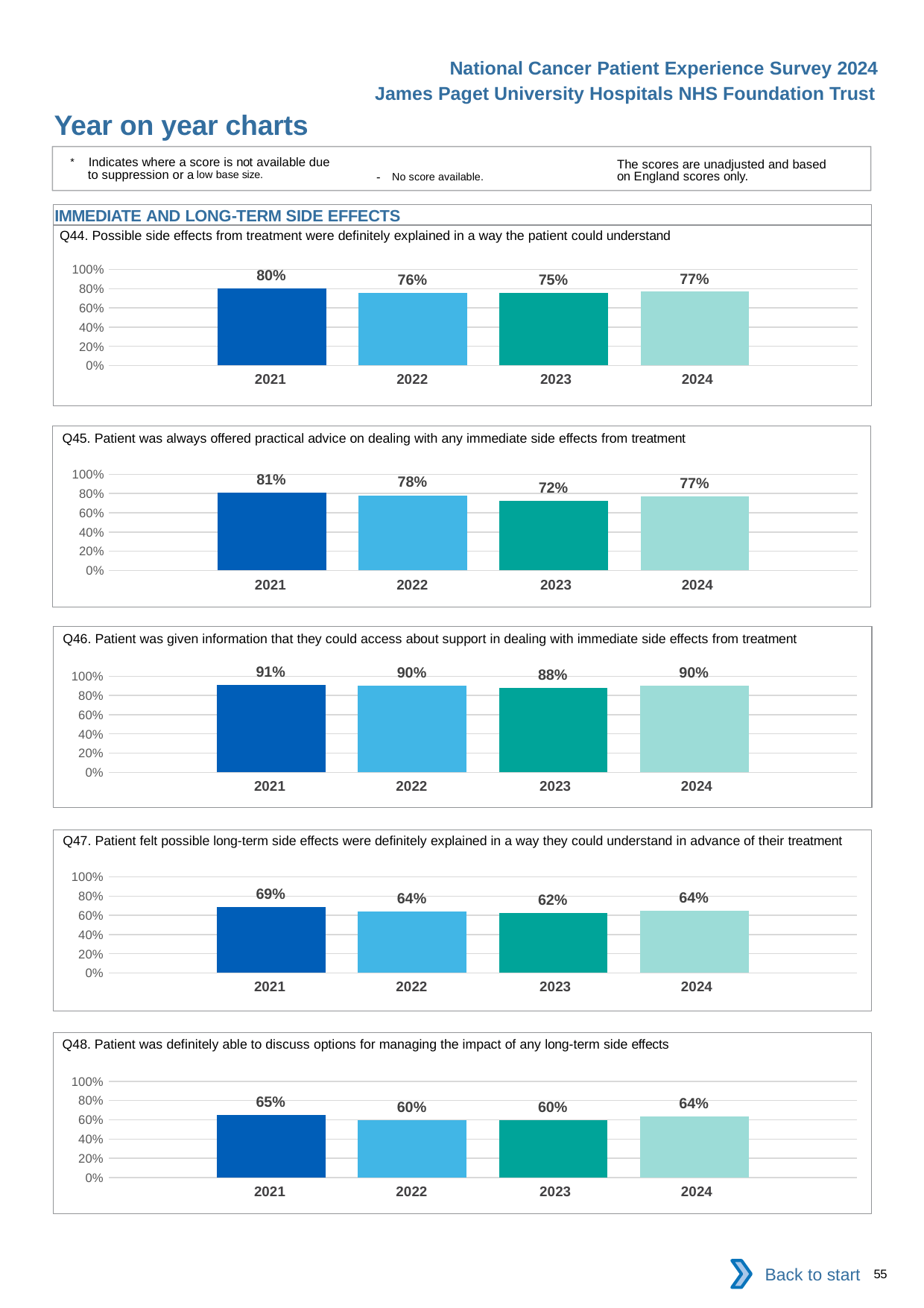
In the Q44 chart, what is the value for 2021? 80% In the Q45 chart, which year has the lowest value? 2023 In the Q45 chart, is the value for 2022 larger than the value for 2024? Yes, 2022 (78%) is larger than 2024 (77%) In the Q46 chart, what is the difference between the 2021 and 2024 values? 1% In the Q46 chart, what is the value for 2023? 88% In the Q48 chart, what is the value for 2024? 64% What type of chart is the Q46 chart? Bar chart What is the section heading above the Q44 chart? IMMEDIATE AND LONG-TERM SIDE EFFECTS In the Q47 chart, what is the difference between the 2021 and 2023 values? 7% In the Q48 chart, which year has the highest value? 2021 In the Q44 chart, how many years are shown on the x axis? 4 In the Q47 chart, do the values rise or fall from 2021 to 2023? Fall